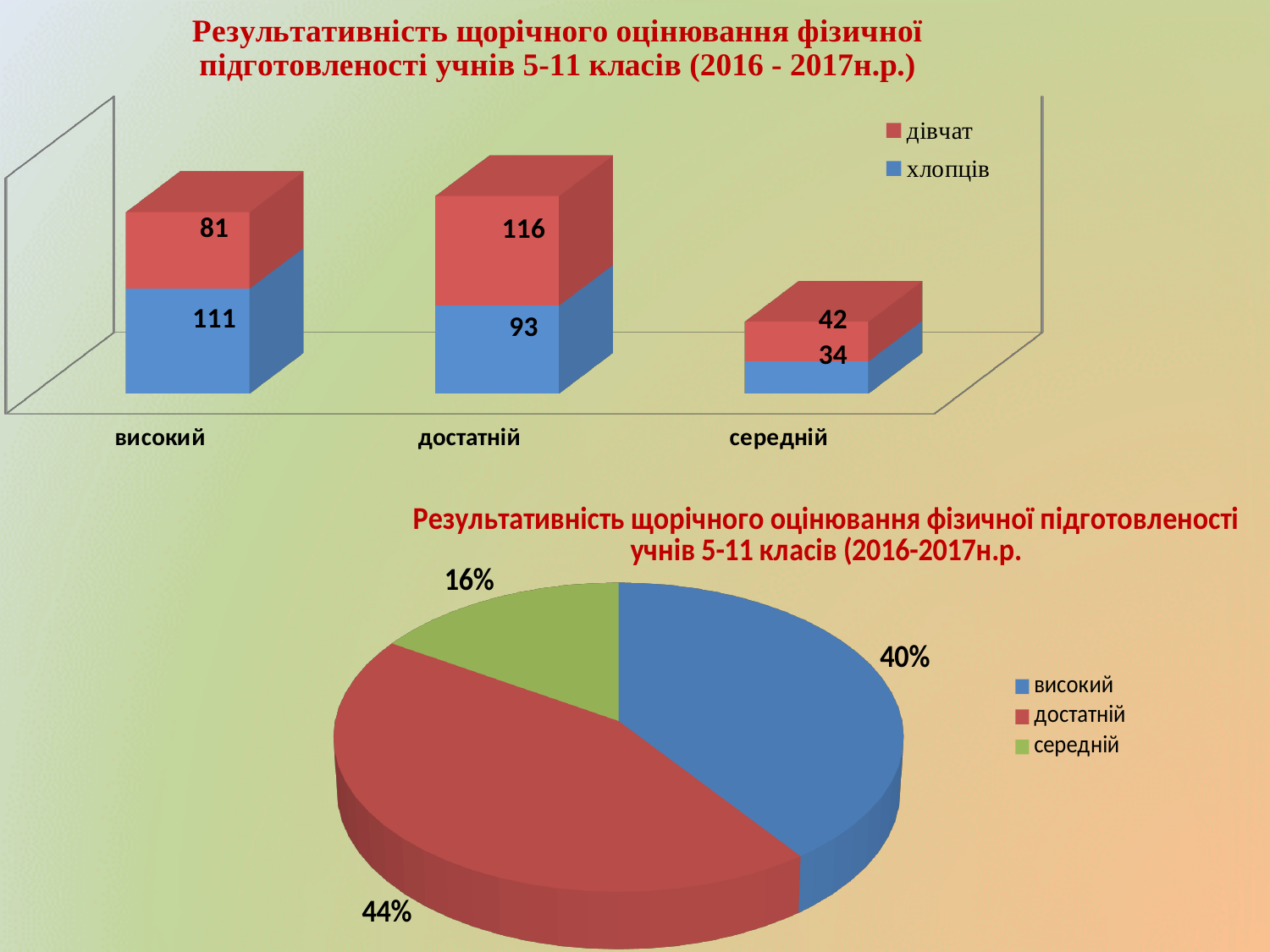
How many slices does the bottom pie chart have? 3 In the top bar chart, what is the value for дівчат in the достатній category? 116 In the top bar chart, what is the total of the stacked bar for достатній? 209 In the top bar chart, which is larger in the середній category, дівчат or хлопців? дівчат How many series does the legend of the top bar chart list? 2 In the top bar chart, which category has the lowest value for хлопців? середній In the bottom pie chart, what share does достатній have? 44% In the bottom pie chart, which category has the smallest slice? середній In the top bar chart, what is the value for хлопців in the високий category? 111 In the top bar chart, what is the value for дівчат in the середній category? 42 In the top bar chart, what is the difference between дівчат and хлопців in the високий category? 30 What kind of chart is the top chart on the slide? bar chart